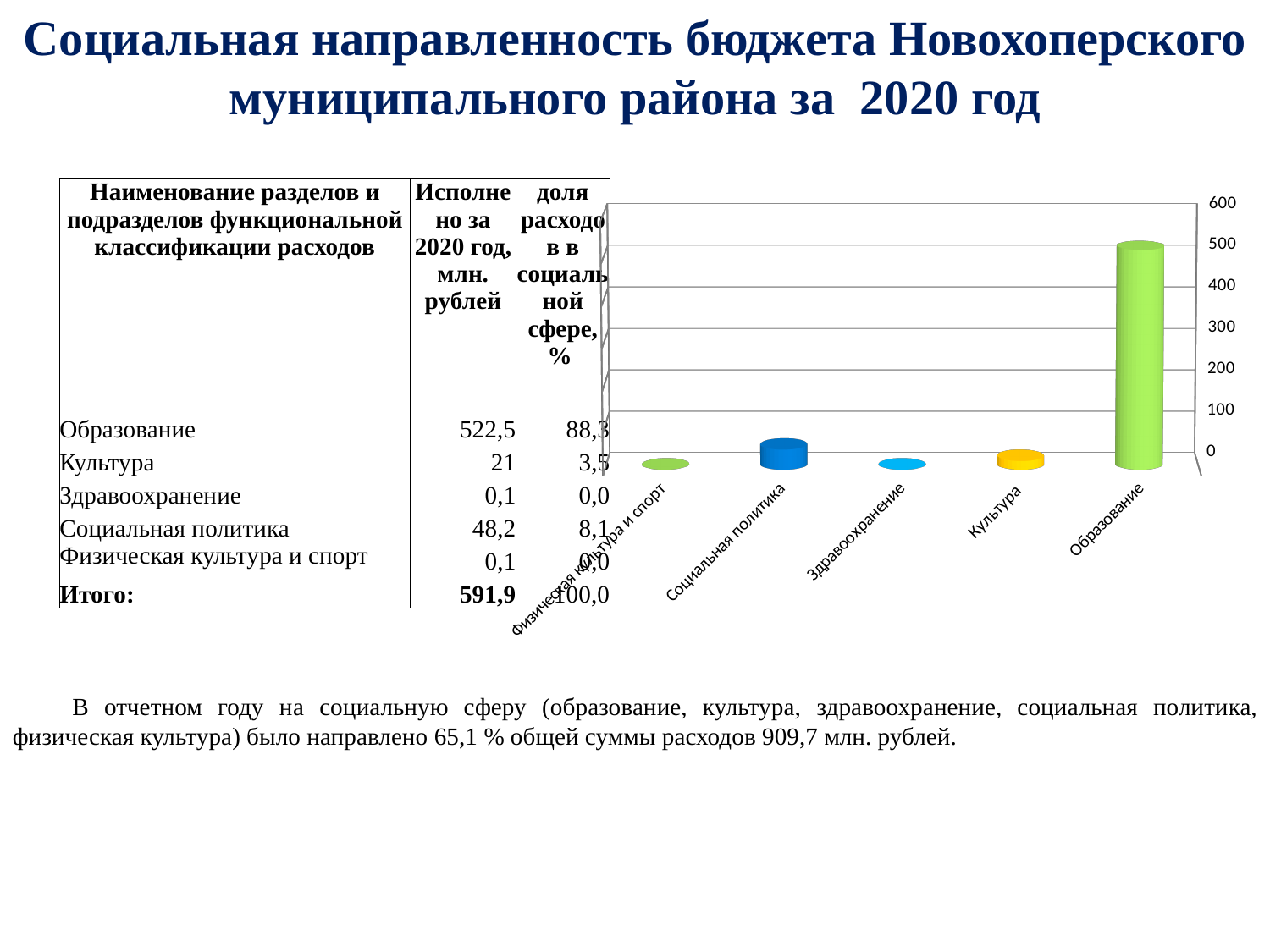
Using the table values, what is the difference in million rubles between Образование and Культура? 501,5 According to the table, what amount in million rubles was executed for Образование in 2020? 522,5 According to the table, what share of social-sphere expenditure does Культура account for? 3,5 What is the total (Итого) of executed expenditure in million rubles shown in the table? 591,9 Which category has the highest bar on the chart? Образование According to the table, what amount in million rubles was executed for Социальная политика in 2020? 48,2 What kind of chart is shown on the slide? bar chart Is the value for Образование greater or less than 400? greater How many categories are plotted on the chart? 5 What is the highest value shown on the chart's vertical axis? 600 Is the value for Социальная политика greater or less than 100? less Which is larger, the value for Социальная политика or the value for Культура? Социальная политика